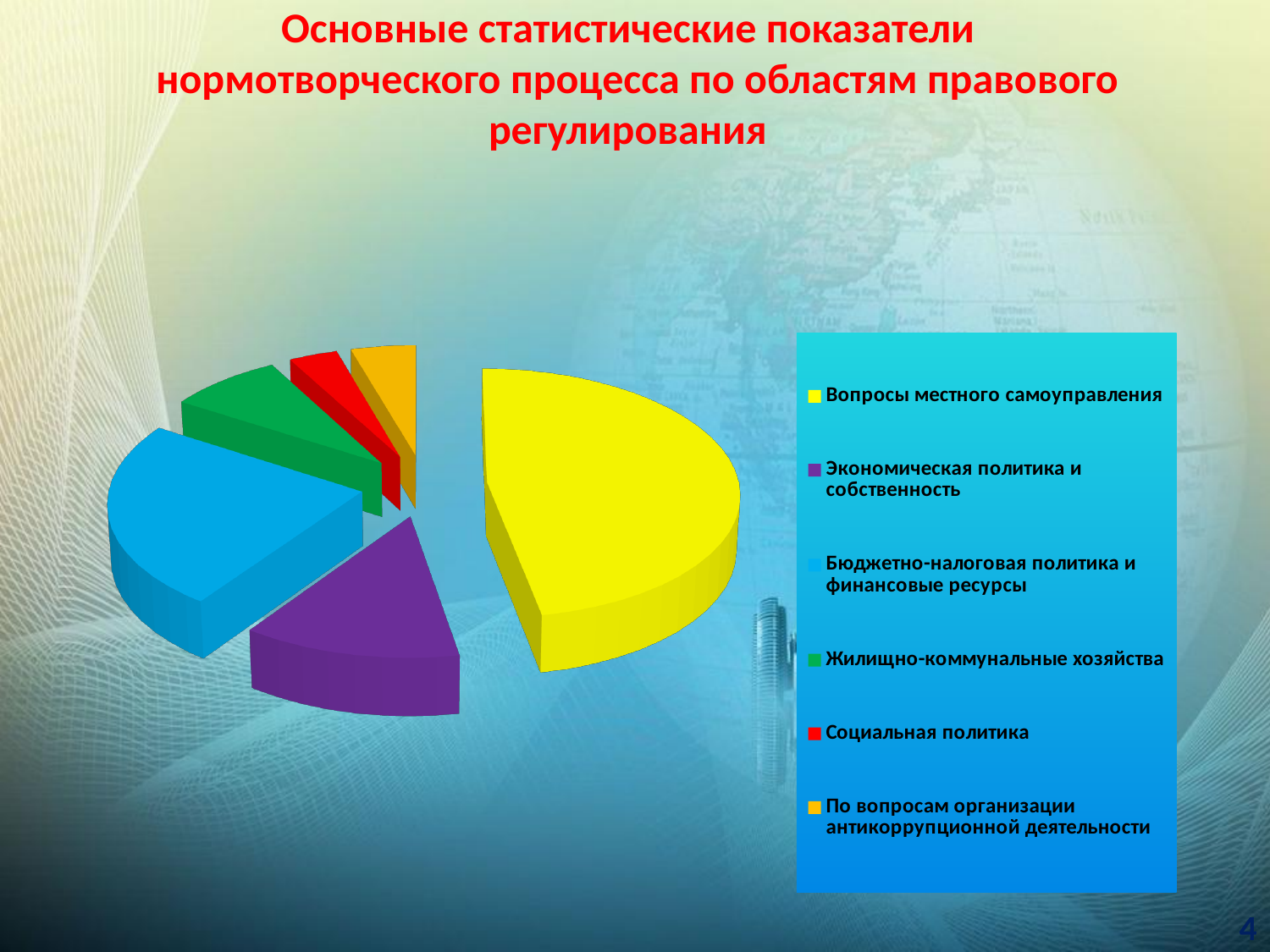
How many slices does the pie chart have? 6 What kind of chart is shown on the slide? pie chart Which slice is larger: Вопросы местного самоуправления or Экономическая политика и собственность? Вопросы местного самоуправления What colour is the slice for Бюджетно-налоговая политика и финансовые ресурсы in the pie chart? blue Which slice is larger: Экономическая политика и собственность or Социальная политика? Экономическая политика и собственность Which category has the largest slice in the pie chart? Вопросы местного самоуправления How many entries does the legend of the pie chart list? 6 Which slice is larger: Бюджетно-налоговая политика и финансовые ресурсы or Жилищно-коммунальные хозяйства? Бюджетно-налоговая политика и финансовые ресурсы What colour is the slice for Социальная политика in the pie chart? red